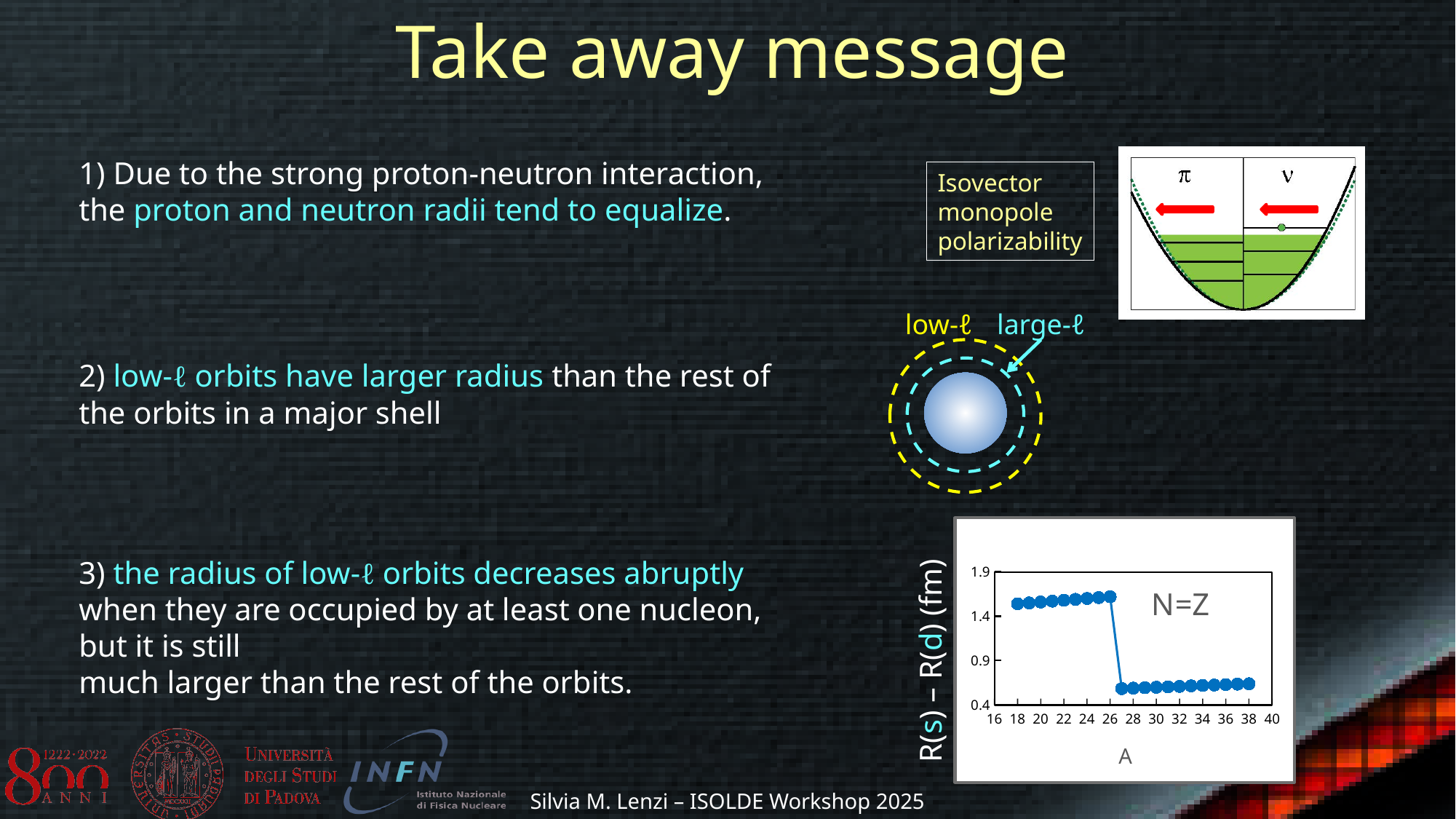
In the bottom-right chart, is the value of R(s) – R(d) at A = 24 greater or less than 1.9? less In the bottom-right chart, which has the smaller value of R(s) – R(d): A = 18 or A = 38? A = 38 In the bottom-right chart, what is the label of the x axis? A In the bottom-right chart, what is the highest tick value shown on the y axis? 1.9 In the bottom-right chart, is the value of R(s) – R(d) at A = 30 greater or less than 0.9? less In the bottom-right chart, what is the label of the y axis? R(s) – R(d) (fm) In the bottom-right chart, which has the larger value of R(s) – R(d): A = 22 or A = 32? A = 22 In the bottom-right chart, is the value of R(s) – R(d) at A = 34 greater or less than 0.4? greater What kind of chart is shown at the bottom right of the slide? scatter chart In the bottom-right chart, how does R(s) – R(d) change as A increases from 26 to 28? It drops abruptly In the bottom-right chart, does R(s) – R(d) generally rise or fall as A increases from 18 to 38? fall